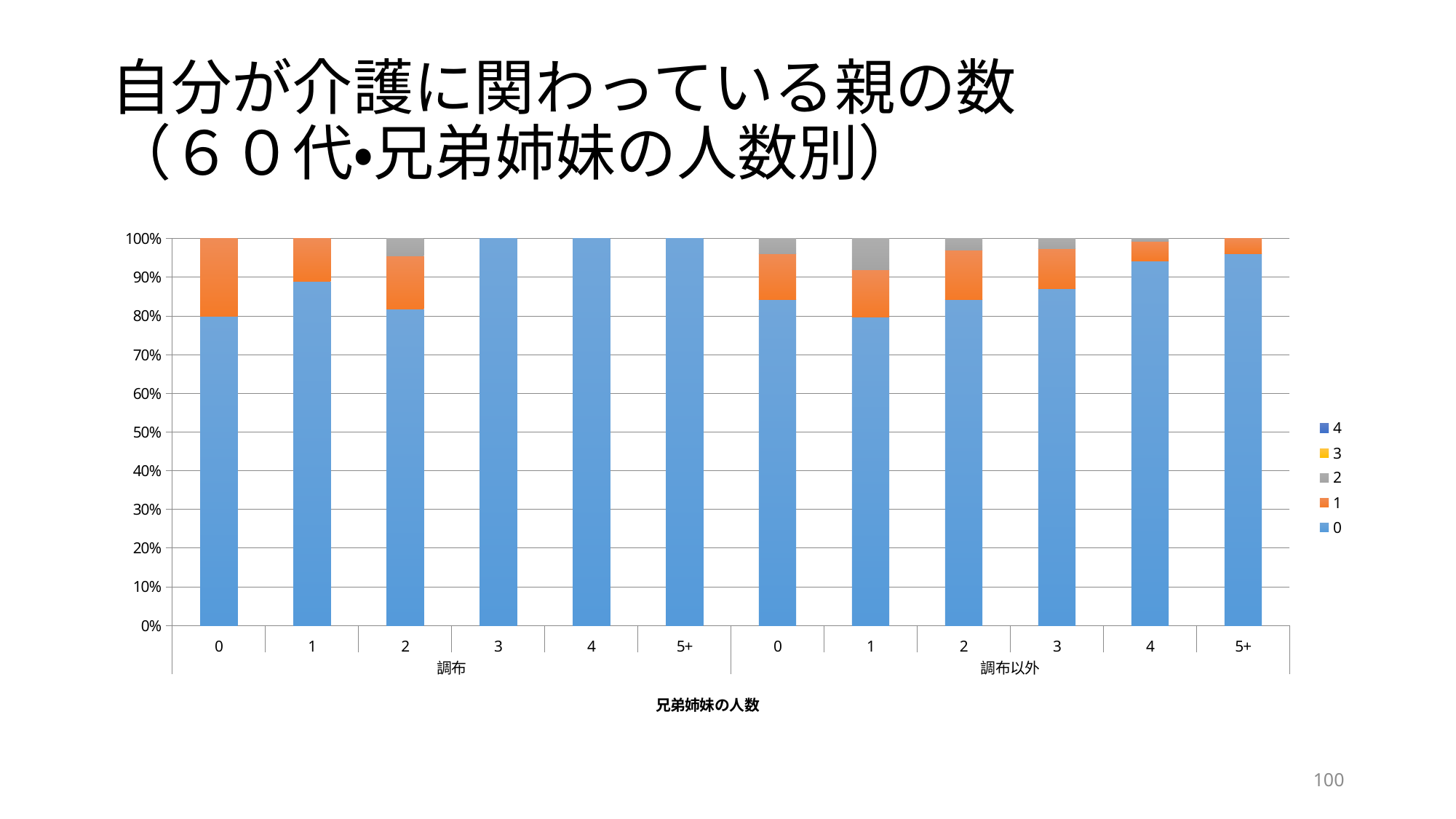
What kind of chart is shown on the slide? stacked bar chart Is the value of series 0 for 調布 1 greater or less than 80%? greater How many bars are plotted in the chart? 12 How many bars are plotted in the 調布 group? 6 How many series does the legend list? 5 Is the value of series 0 for 調布以外 4 greater or less than 90%? greater Which has the larger value for series 0: 調布以外 1 or 調布以外 4? 調布以外 4 Is the value of series 0 for 調布 1 greater or less than 90%? less What is the total of the stacked bar for 調布 3? 100% Which has the larger value for series 0: 調布 0 or 調布 1? 調布 1 What is the x-axis title of the chart? 兄弟姉妹の人数